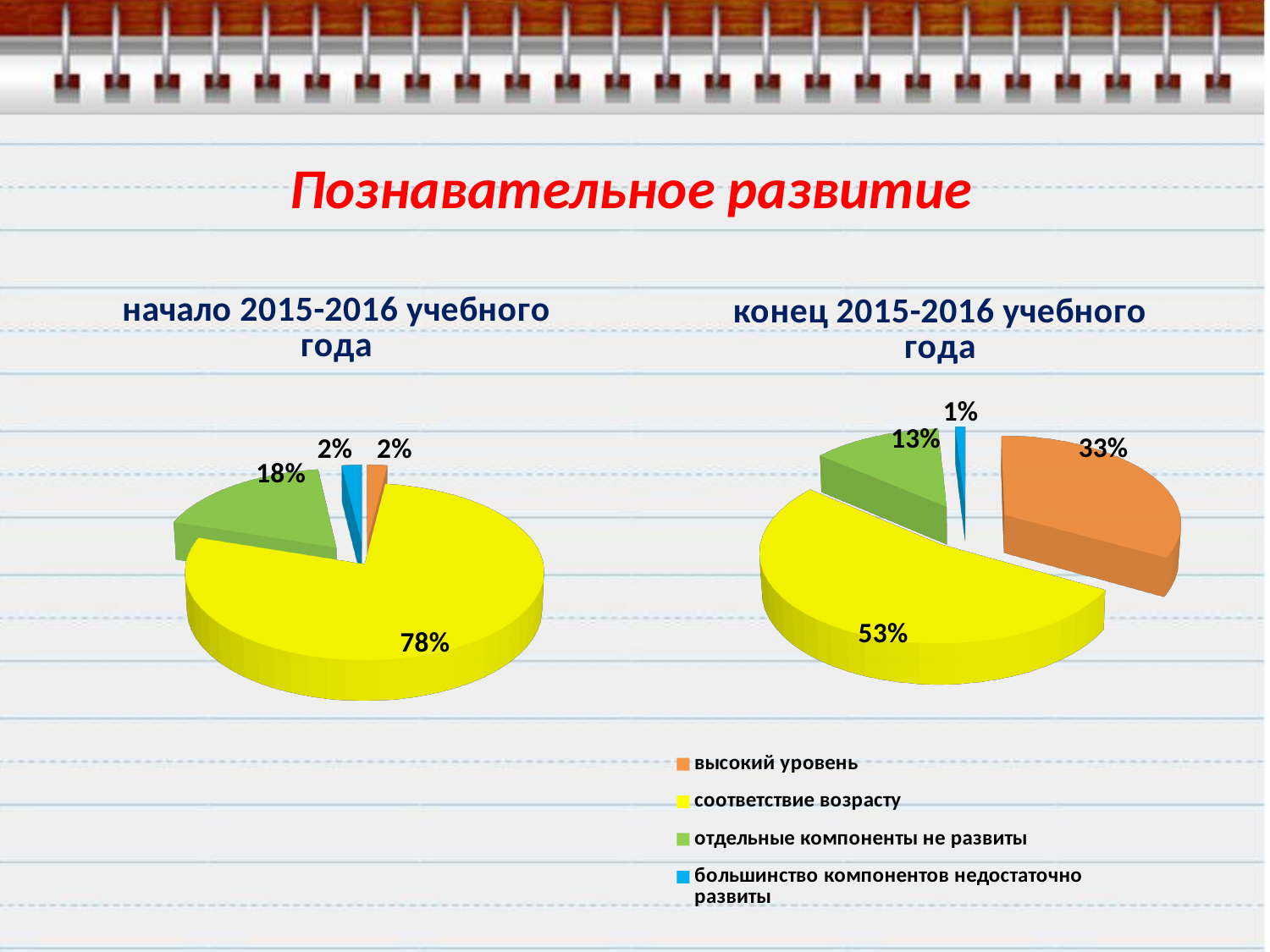
In the chart titled "конец 2015-2016 учебного года", what share does "большинство компонентов недостаточно развиты" have? 1% In the chart titled "начало 2015-2016 учебного года", which category has the largest slice? соответствие возрасту In the chart titled "начало 2015-2016 учебного года", what share does "отдельные компоненты не развиты" have? 18% In the chart titled "конец 2015-2016 учебного года", which category has the largest slice? соответствие возрасту What is the difference between the "высокий уровень" share in the chart titled "конец 2015-2016 учебного года" and in the chart titled "начало 2015-2016 учебного года"? 31% What type of chart is used on this slide? pie chart In the chart titled "конец 2015-2016 учебного года", which is larger: "высокий уровень" or "отдельные компоненты не развиты"? высокий уровень How many categories does the legend list? 4 What colour represents "соответствие возрасту" in the charts? yellow In the chart titled "конец 2015-2016 учебного года", what share does "высокий уровень" have? 33% In the chart titled "конец 2015-2016 учебного года", which category has the smallest slice? большинство компонентов недостаточно развиты In the chart titled "начало 2015-2016 учебного года", what share does "соответствие возрасту" have? 78%